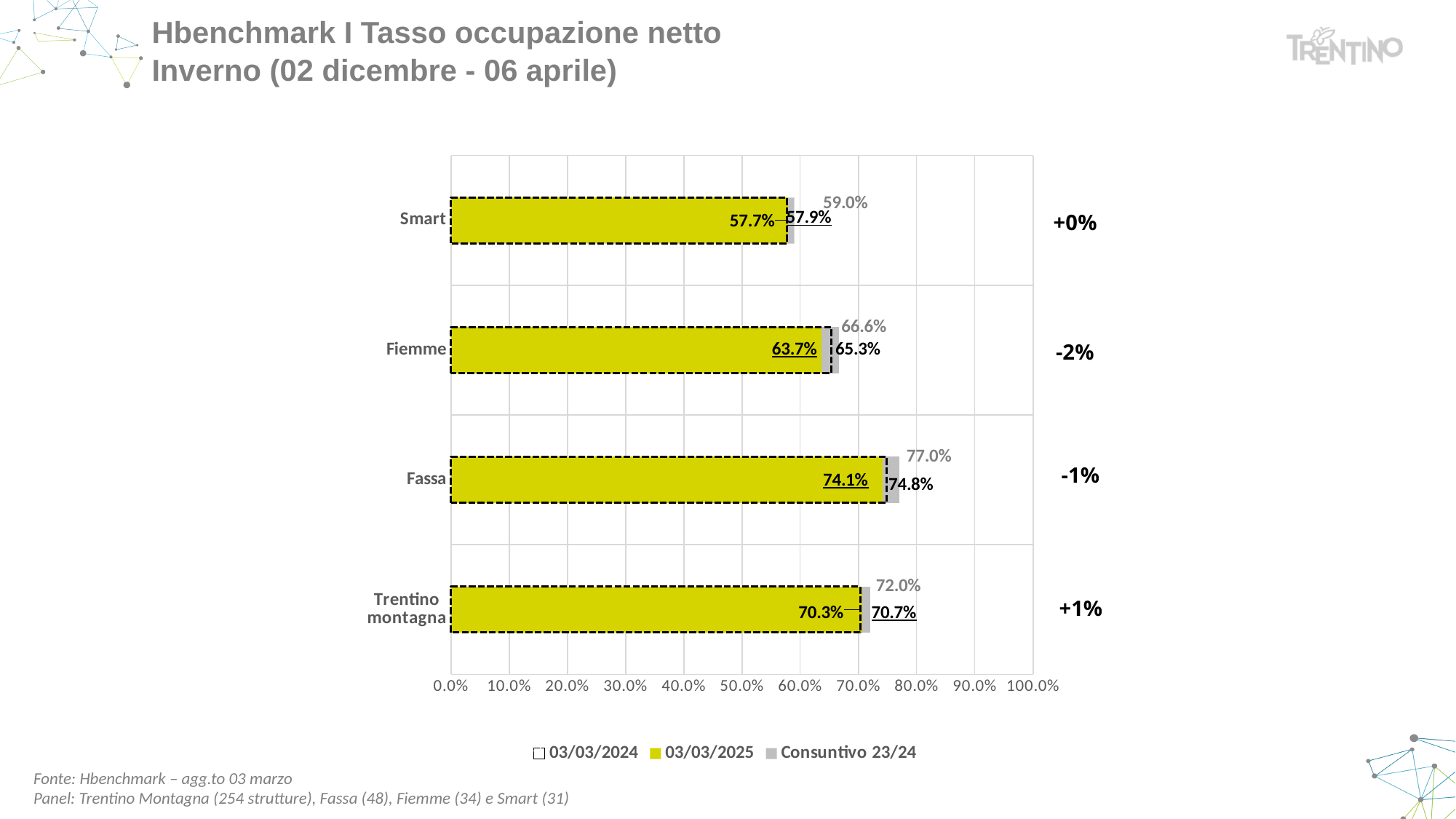
What is the Consuntivo 23/24 value for Fassa? 77.0% What percentage change is shown to the right of the chart for Fiemme? -2% How many categories are plotted on the chart? 4 What is the difference between the Consuntivo 23/24 values for Fassa and Fiemme? 10.4 percentage points Which category has the lowest Consuntivo 23/24 value? Smart How many series does the chart legend list? 3 What kind of chart is shown on the slide? Bar chart What is the Consuntivo 23/24 value for Trentino montagna? 72.0% What is the Consuntivo 23/24 value for Smart? 59.0% Which has the larger Consuntivo 23/24 value, Fiemme or Trentino montagna? Trentino montagna Is the 03/03/2025 value for Fassa greater or less than 70.0%? greater Which category has the highest Consuntivo 23/24 value? Fassa